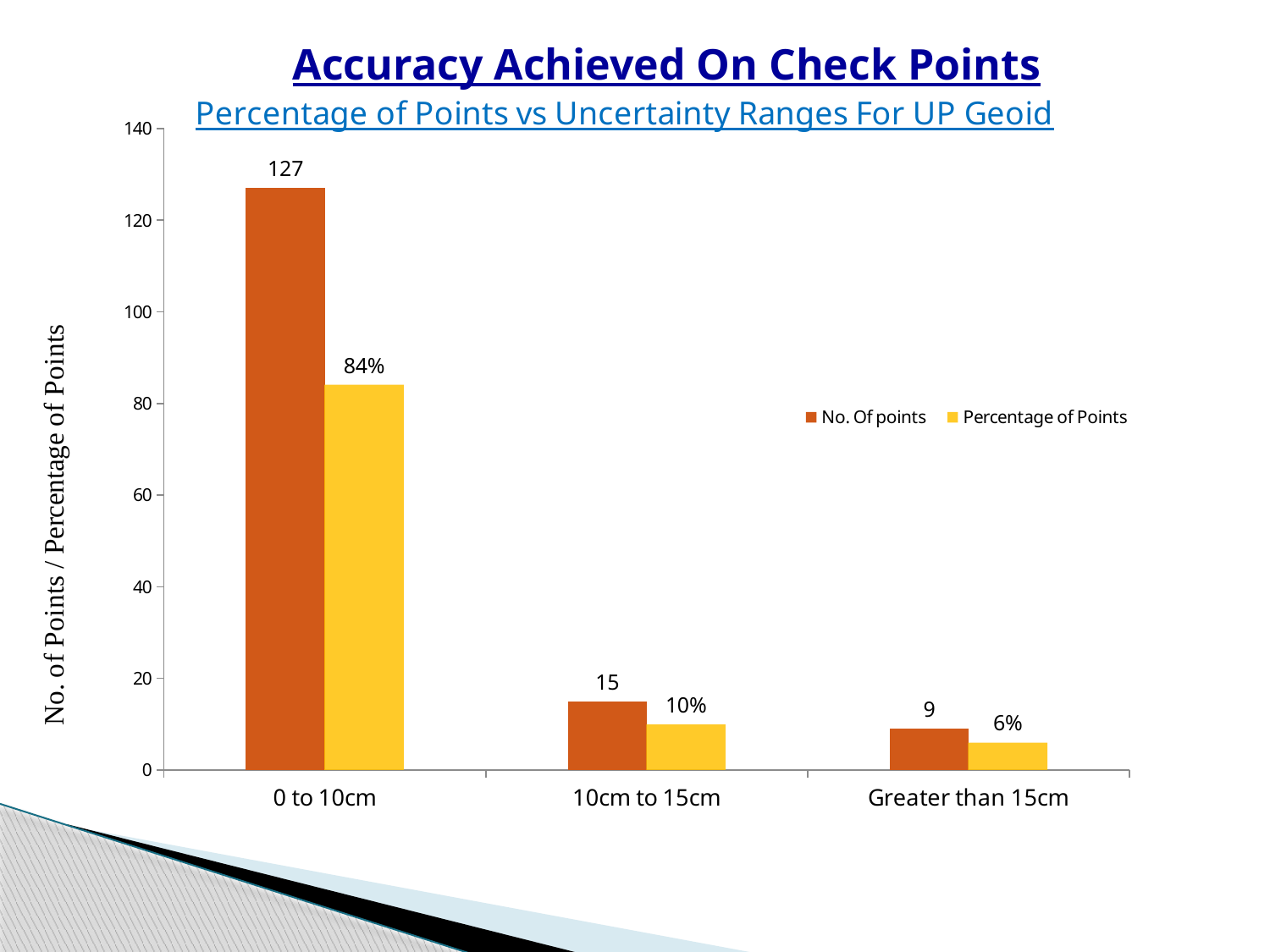
What is the number of points for the Greater than 15cm range? 9 How many uncertainty ranges are shown on the x axis? 3 Which uncertainty range has the lowest percentage of points? Greater than 15cm What is the percentage of points for the Greater than 15cm range? 6% Do the number of points rise or fall from the 0 to 10cm range to the Greater than 15cm range? Fall What is the number of points for the 0 to 10cm range? 127 What kind of chart is shown on the slide? Bar chart What is the percentage of points for the 10cm to 15cm range? 10% Which uncertainty range has the highest number of points? 0 to 10cm What is the difference in number of points between the 0 to 10cm range and the 10cm to 15cm range? 112 Which has more points, the 10cm to 15cm range or the Greater than 15cm range? 10cm to 15cm How many series does the legend list? 2